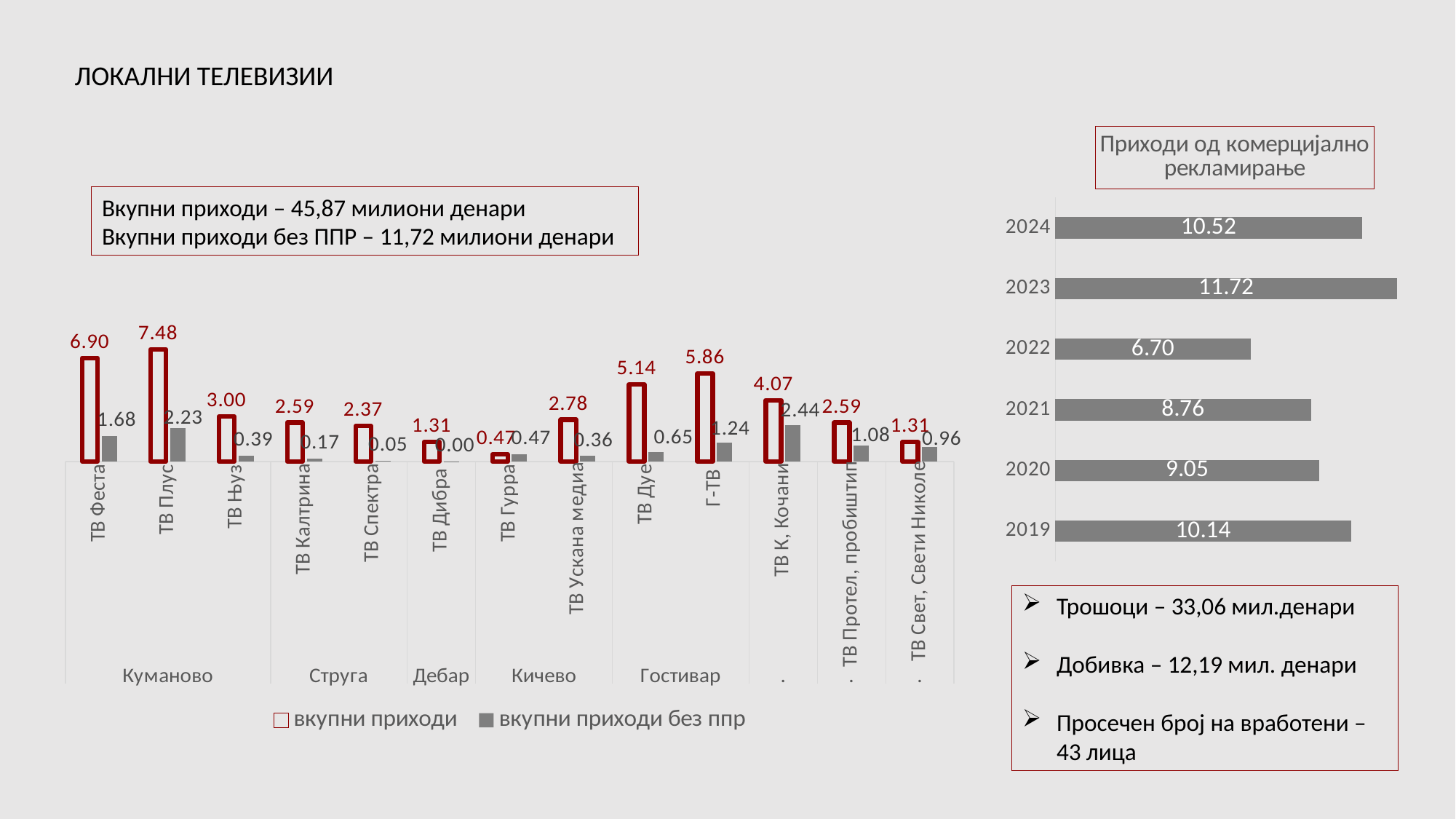
In the chart titled 'Приходи од комерцијално рекламирање', which year has the lowest value? 2022 In the chart titled 'Приходи од комерцијално рекламирање', what is the value for 2023? 11.72 In the left chart of local TV stations, what is the difference between the 'вкупни приходи' and 'вкупни приходи без ппр' values for ТВ Феста? 5.22 In the left chart of local TV stations, which station has the lowest 'вкупни приходи без ппр' value? ТВ Дибра How many series does the legend of the left chart of local TV stations list? 2 In the chart titled 'Приходи од комерцијално рекламирање', which year has the highest value? 2023 In the left chart of local TV stations, which station has the highest 'вкупни приходи' value? ТВ Плус In the left chart of local TV stations, what is the 'вкупни приходи без ппр' value for ТВ К, Кочани? 2.44 In the chart titled 'Приходи од комерцијално рекламирање', what is the difference between the values for 2024 and 2022? 3.82 In the left chart of local TV stations, what is the 'вкупни приходи' value for ТВ Плус? 7.48 In the chart titled 'Приходи од комерцијално рекламирање', how many years are shown? 6 In the left chart of local TV stations, which is larger: the 'вкупни приходи' value for ТВ Дуе or for Г-ТВ? Г-ТВ